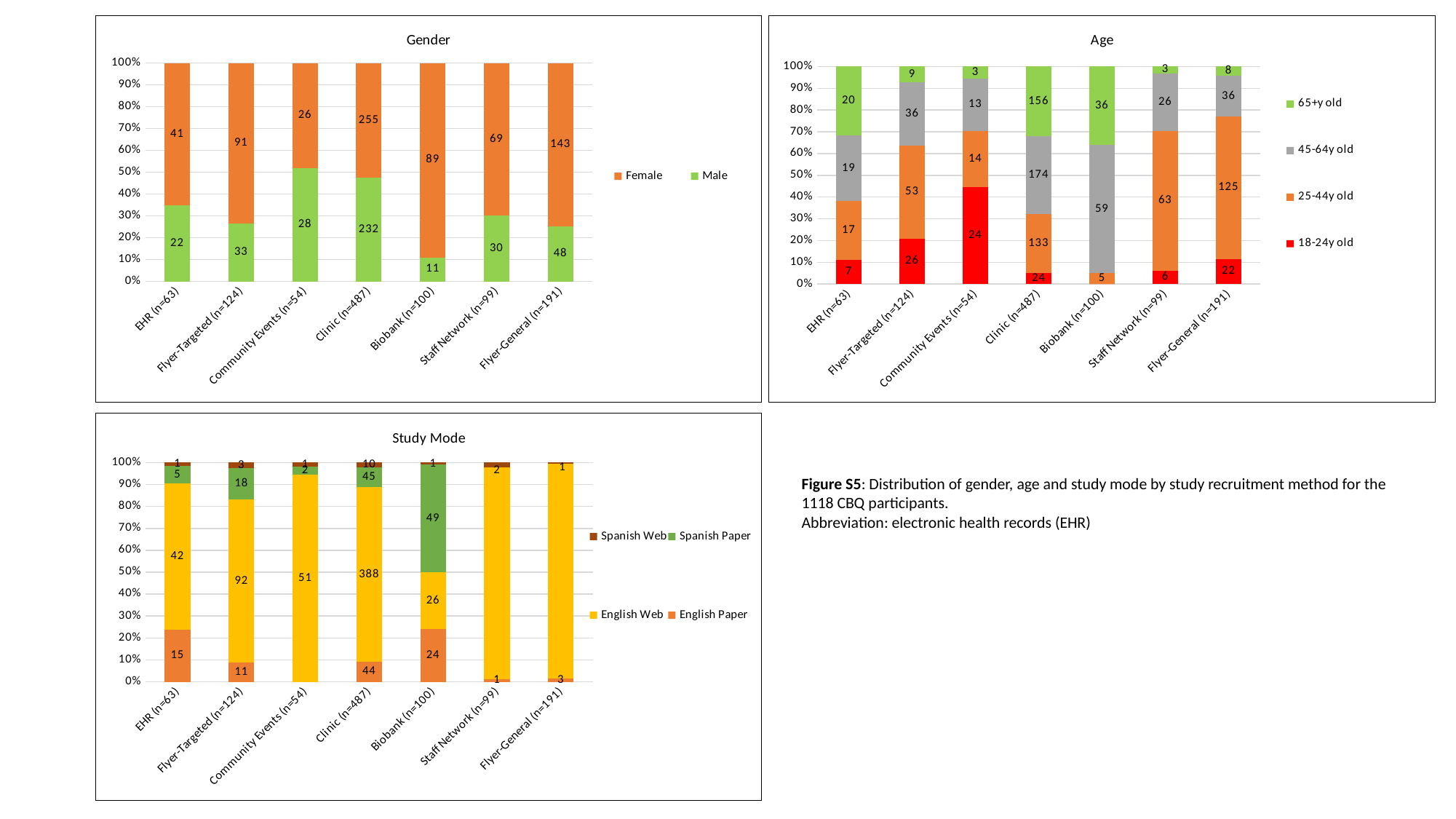
What kind of chart is the Study Mode chart? Stacked bar chart In the Age chart, which recruitment method has the largest number of 65+y old participants? Clinic (n=487) In the Gender chart, is the Female share of the Biobank (n=100) bar greater or less than 80%? greater In the Gender chart, how many series does the legend list? 2 In the Age chart, how many 45-64y old participants are shown for Clinic (n=487)? 174 In the Gender chart, what is the difference between the Female and Male counts for Flyer-General (n=191)? 95 In the Study Mode chart, how many English Web participants are shown for Clinic (n=487)? 388 In the Gender chart, how many recruitment method categories are shown on the x axis? 7 In the Gender chart, how many Female participants are shown for Clinic (n=487)? 255 In the Age chart, how many series does the legend list? 4 In the Gender chart, how many Male participants are shown for Biobank (n=100)? 11 In the Age chart, how many 18-24y old participants are shown for Flyer-Targeted (n=124)? 26